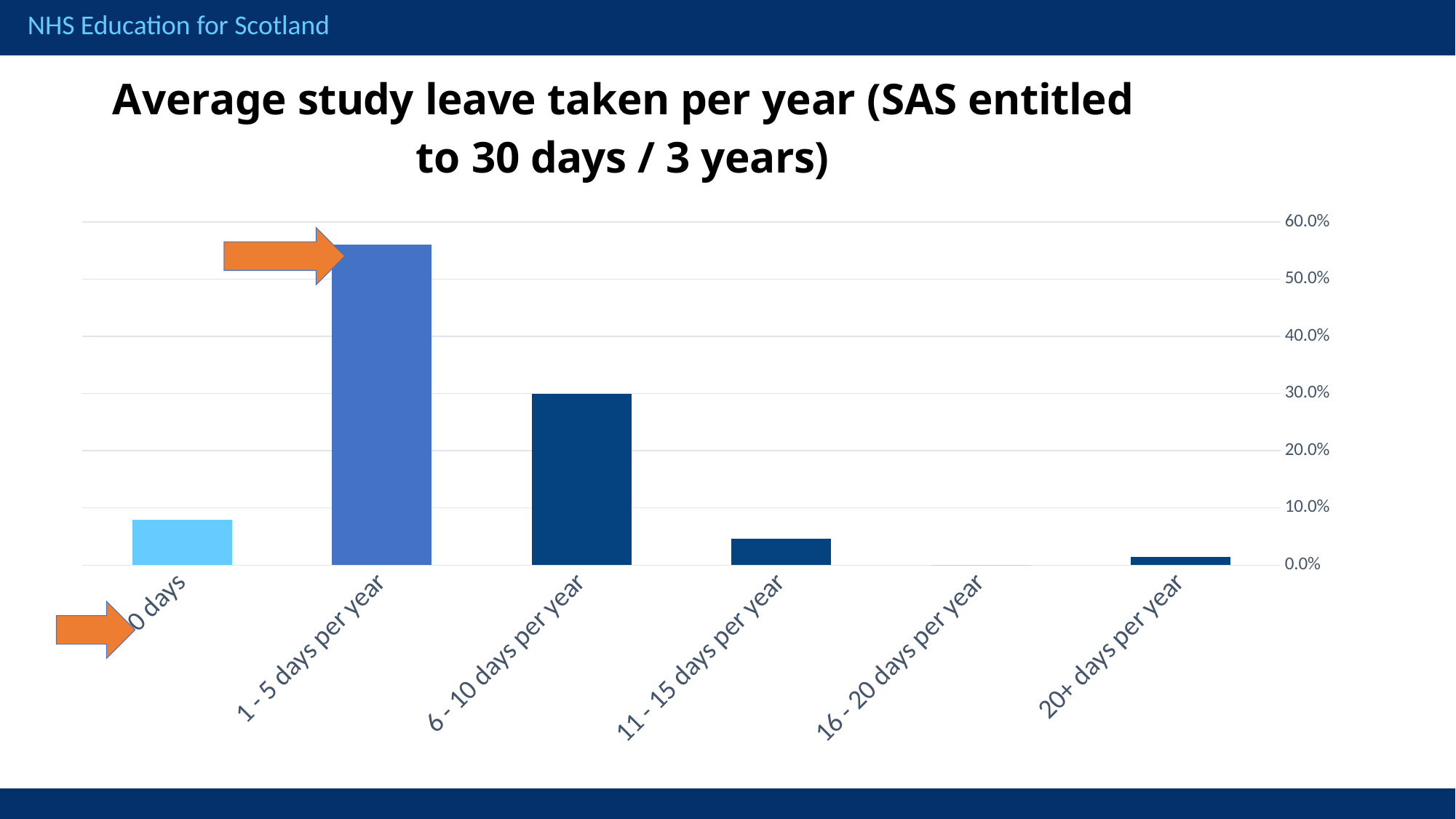
How many categories are shown on the x axis of the chart? 6 Is the value for 6 - 10 days per year greater or less than 40.0%? less Which is larger, the value for 0 days or the value for 20+ days per year? 0 days Is the value for 11 - 15 days per year greater or less than 10.0%? less What is the title of the chart? Average study leave taken per year (SAS entitled to 30 days / 3 years) Is the value for 0 days greater or less than 10.0%? less What is the highest value shown on the chart's y axis? 60.0% Which is larger, the value for 6 - 10 days per year or the value for 11 - 15 days per year? 6 - 10 days per year Which category has the lowest value in the chart? 16 - 20 days per year What kind of chart is shown on the slide? Bar chart Which category has the highest value in the chart? 1 - 5 days per year